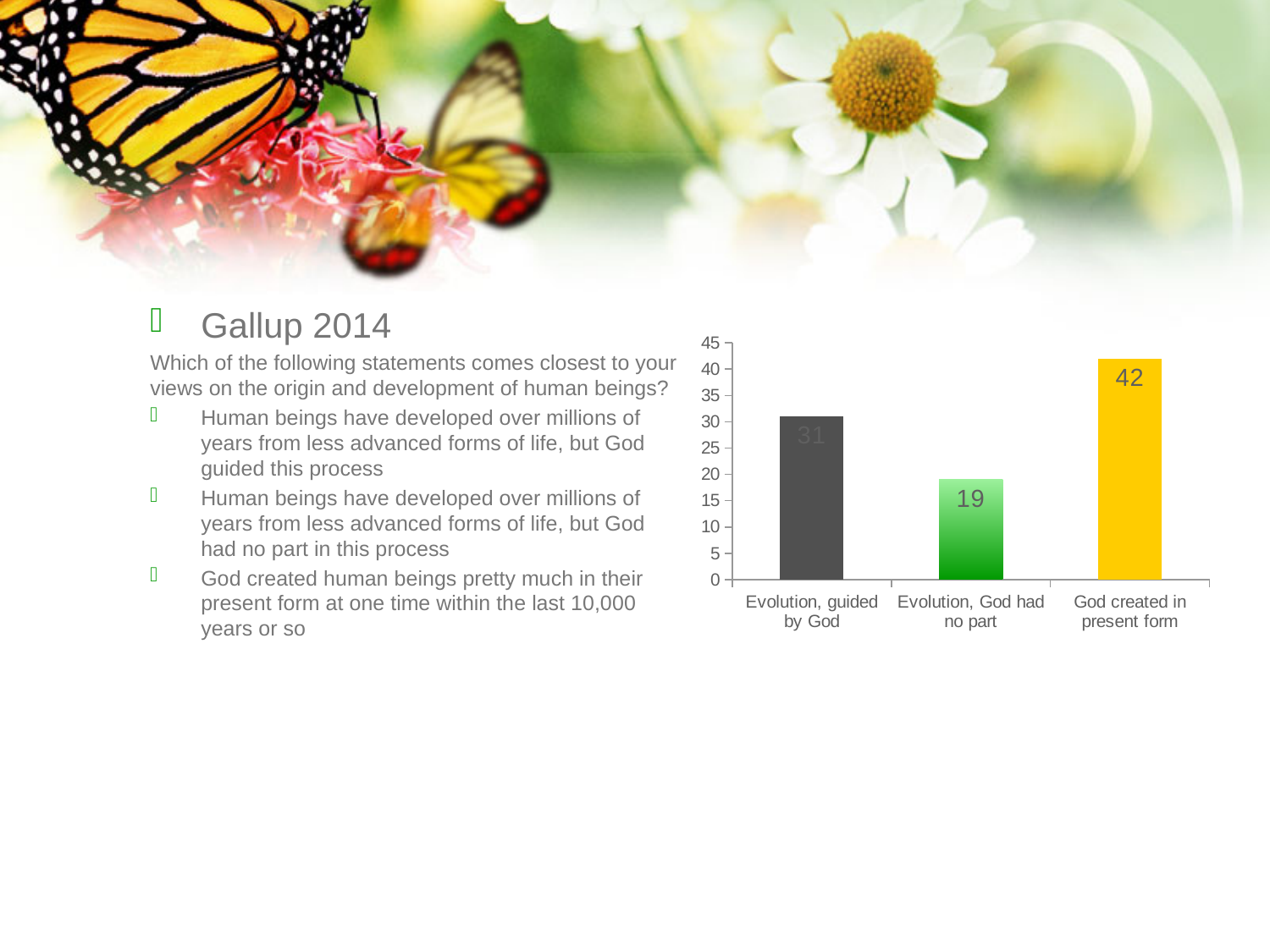
What colour is the bar for "God created in present form"? yellow What kind of chart is shown on the slide? bar chart How many categories are shown on the chart? 3 What is the difference between the values for "God created in present form" and "Evolution, guided by God"? 11 What is the value for "God created in present form"? 42 What is the value for "Evolution, guided by God"? 31 Is the value for "God created in present form" greater or less than 40? greater What is the difference between the values for "Evolution, guided by God" and "Evolution, God had no part"? 12 Which category has the lowest value? Evolution, God had no part What is the value for "Evolution, God had no part"? 19 Which category has the highest value? God created in present form Which is larger, the value for "Evolution, guided by God" or the value for "Evolution, God had no part"? Evolution, guided by God